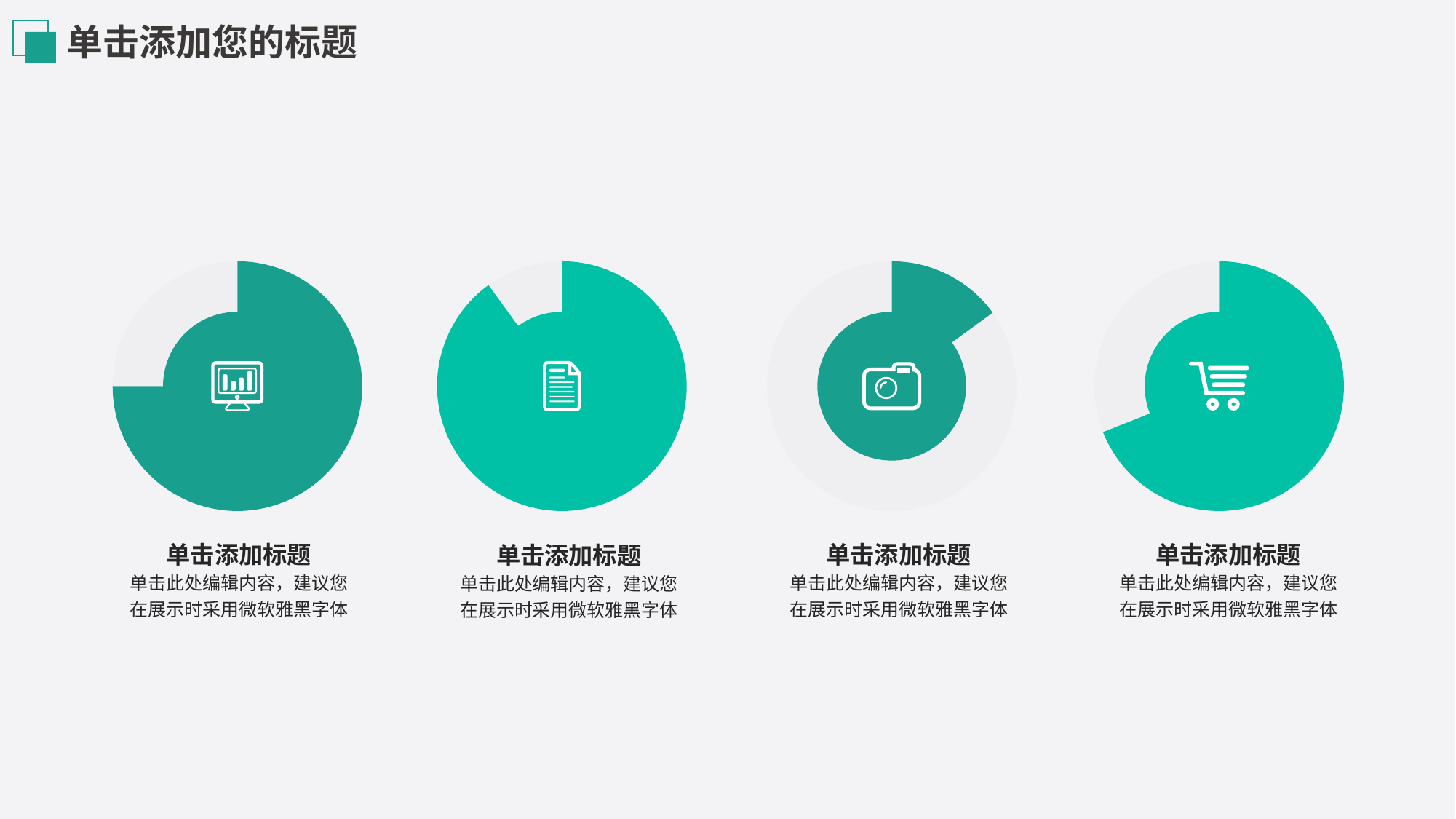
What icon is shown in the centre of the third pie chart from the left? a camera Is the filled portion of the first pie chart from the left larger or smaller than that of the third pie chart? larger What kind of chart are the four circular graphics on the slide? pie chart Which pie chart, counted from the left, has the smallest filled (coloured) portion? the third Which pie chart, counted from the left, has the largest filled (coloured) portion? the second How many pie charts are shown on the slide? 4 What icon is shown in the centre of the fourth pie chart from the left? a shopping cart Is the filled portion of the fourth pie chart from the left larger or smaller than that of the second pie chart? smaller